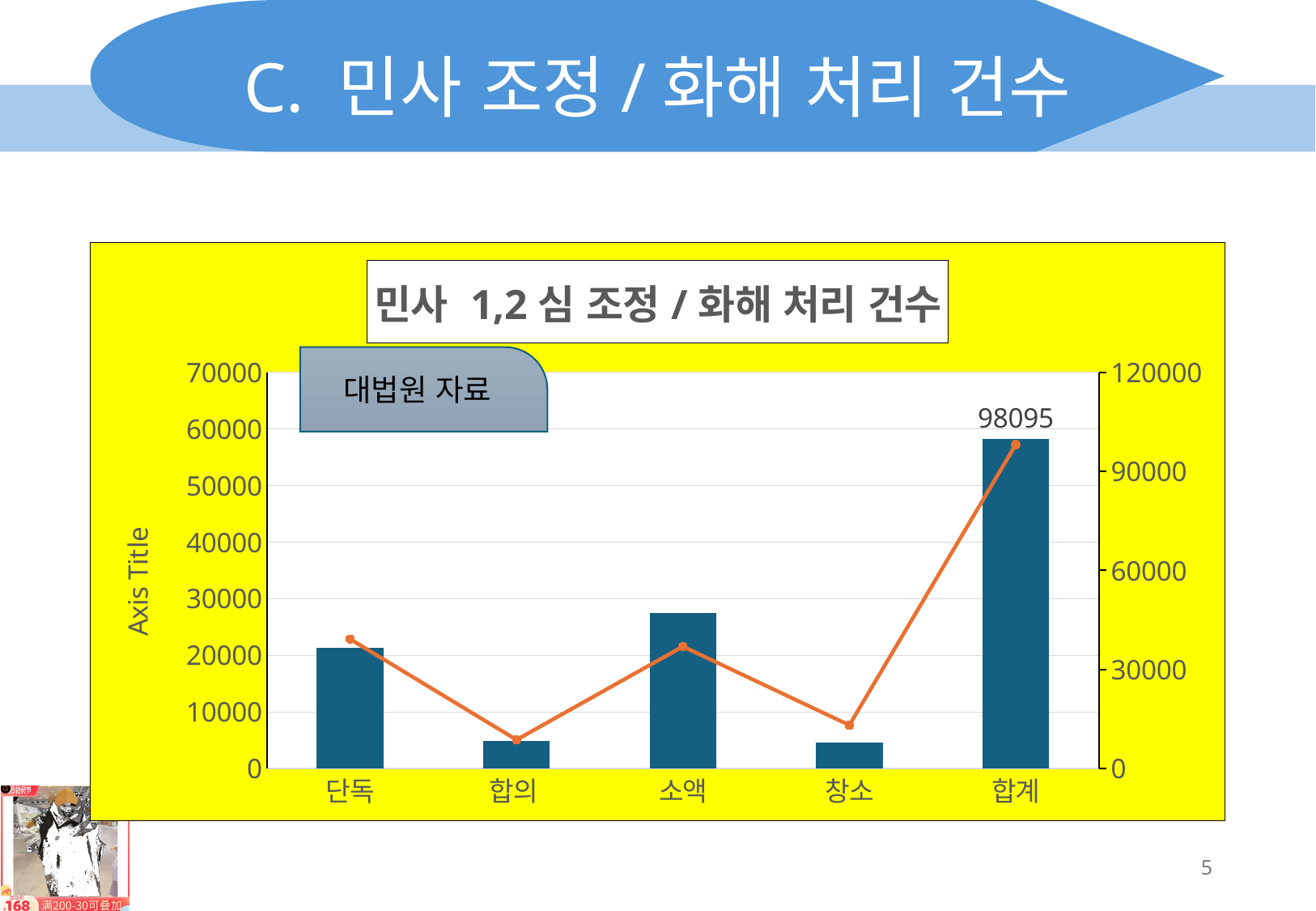
What kind of chart is shown? bar chart with a line Which category has the lowest point on the orange line? 합의 Which bar is taller, 단독 or 소액? 소액 What value is labelled on the line at 합계? 98095 Is the bar for 단독 greater or less than 30000 on the left axis? less Is the bar for 소액 greater or less than 20000 on the left axis? greater Is the bar for 합계 greater or less than 50000 on the left axis? greater Do the bars rise or fall from 합의 to 소액? rise What is the title of the chart? 민사 1,2 심 조정 / 화해 처리 건수 What is the highest tick value shown on the right-hand axis? 120000 How many categories are shown on the x axis? 5 Which category has the tallest bar? 합계